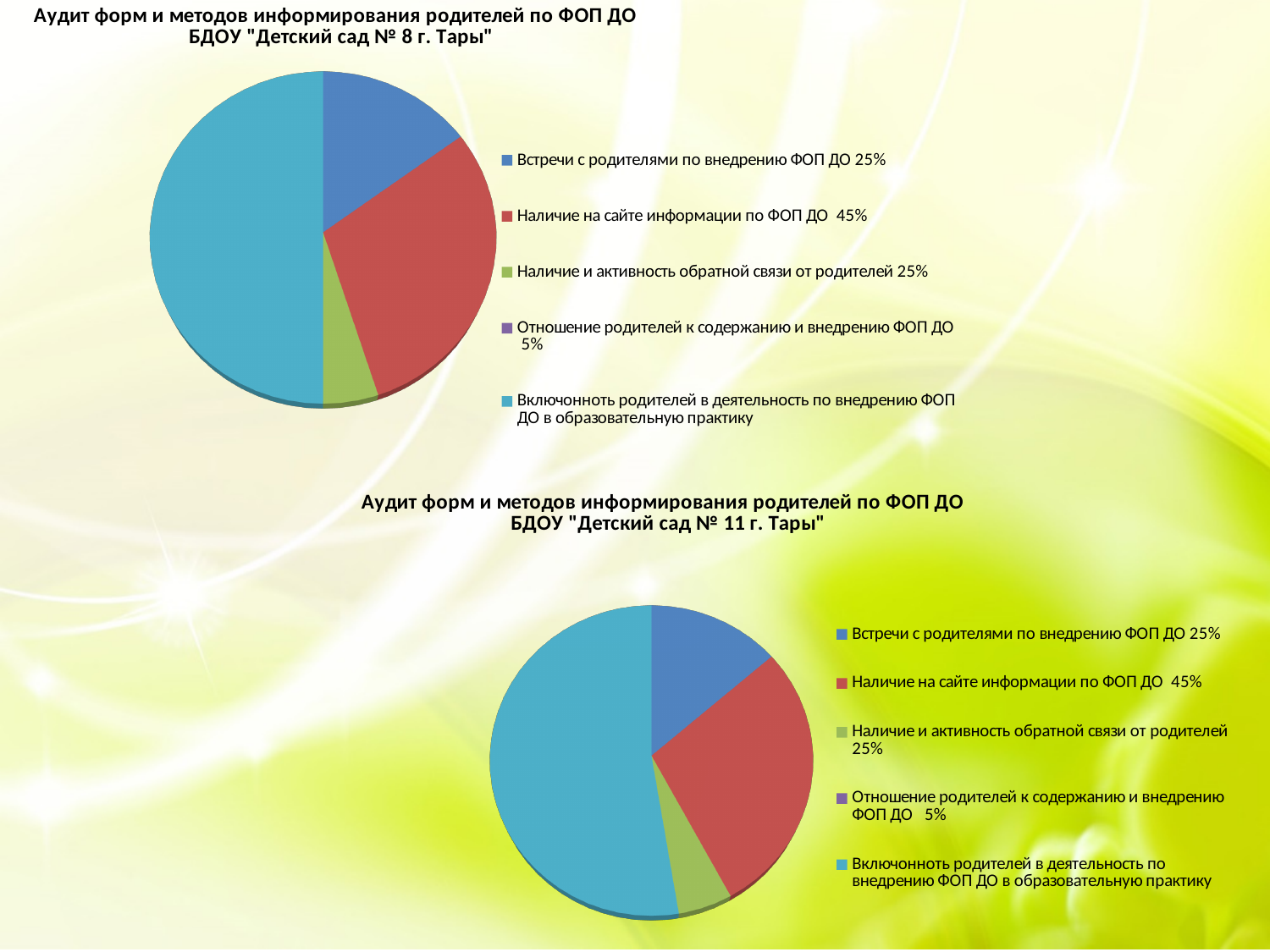
In the bottom chart (Детский сад № 11), what colour is the legend marker for "Встречи с родителями по внедрению ФОП ДО"? Blue In the bottom chart (Детский сад № 11), how many entries does the legend list? 5 What is the title of the top chart on the slide? Аудит форм и методов информирования родителей по ФОП ДО БДОУ "Детский сад № 8 г. Тары" In the top chart (Детский сад № 8), which slice is larger: "Наличие на сайте информации по ФОП ДО" or "Встречи с родителями по внедрению ФОП ДО"? Наличие на сайте информации по ФОП ДО In the bottom chart (Детский сад № 11), which slice is larger: "Включонность родителей в деятельность по внедрению ФОП ДО в образовательную практику" or "Наличие на сайте информации по ФОП ДО"? Включонноть родителей в деятельность по внедрению ФОП ДО в образовательную практику What kind of chart is the top chart titled "Аудит форм и методов информирования родителей по ФОП ДО БДОУ "Детский сад № 8 г. Тары""? Pie chart In the top chart (Детский сад № 8), how many entries does the legend list? 5 In the bottom chart (Детский сад № 11), which slice is larger: "Встречи с родителями по внедрению ФОП ДО" or "Наличие и активность обратной связи от родителей"? Встречи с родителями по внедрению ФОП ДО What kind of chart is the bottom chart titled "Аудит форм и методов информирования родителей по ФОП ДО БДОУ "Детский сад № 11 г. Тары""? Pie chart In the top chart (Детский сад № 8), which legend category has the largest slice? Включонноть родителей в деятельность по внедрению ФОП ДО в образовательную практику In the bottom chart (Детский сад № 11), which legend category has the largest slice? Включонноть родителей в деятельность по внедрению ФОП ДО в образовательную практику